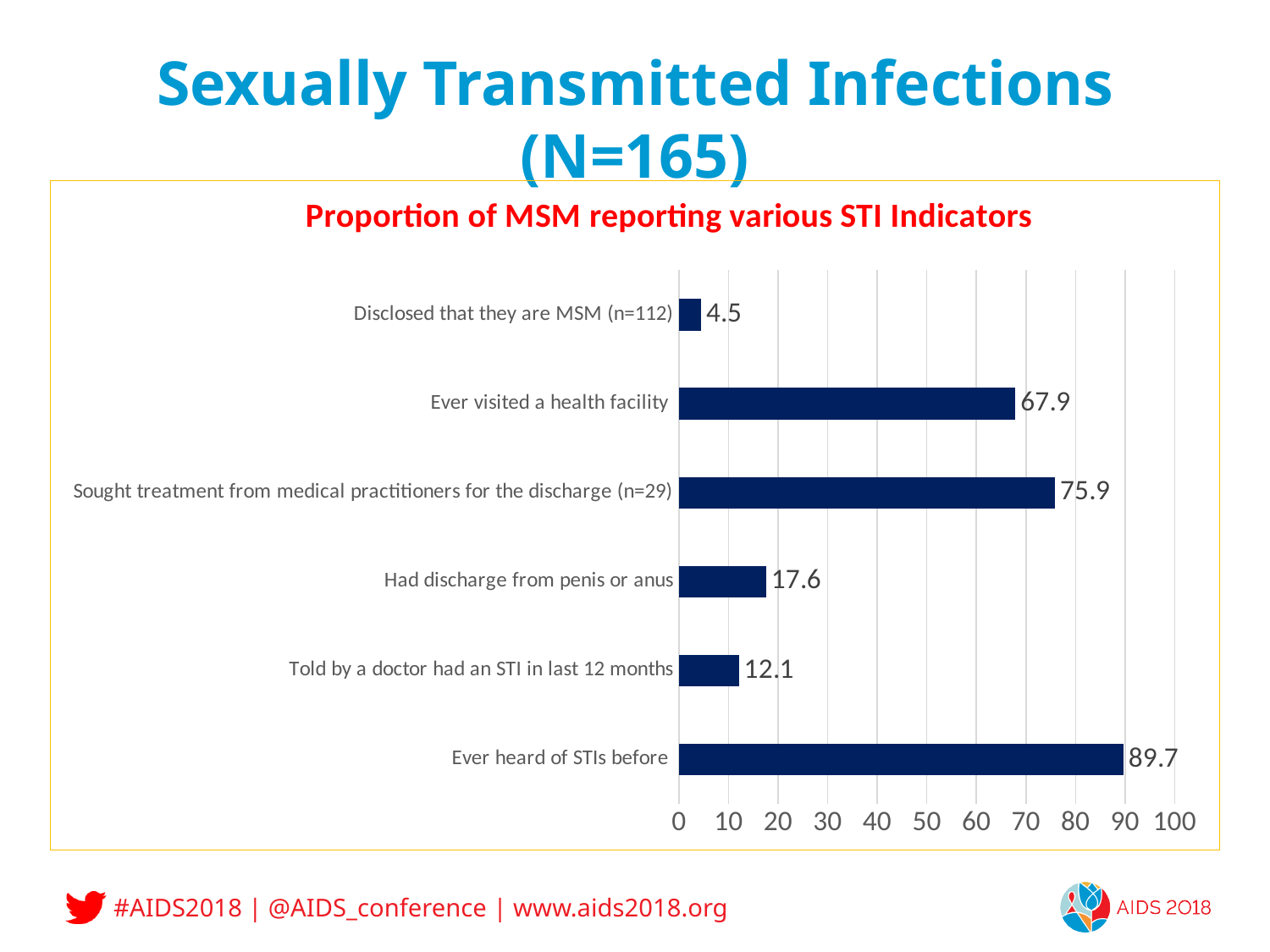
What kind of chart is shown on the slide? Bar chart Which category has the lowest value? Disclosed that they are MSM (n=112) Which is larger: 'Had discharge from penis or anus' or 'Told by a doctor had an STI in last 12 months'? Had discharge from penis or anus What is the value for 'Ever heard of STIs before'? 89.7 Which category has the highest value? Ever heard of STIs before What is the maximum value shown on the x axis? 100 What is the difference between 'Sought treatment from medical practitioners for the discharge (n=29)' and 'Ever visited a health facility'? 8 How many categories are shown in the chart? 6 What is the title of the chart? Proportion of MSM reporting various STI Indicators What is the value for 'Disclosed that they are MSM (n=112)'? 4.5 Is the value for 'Ever visited a health facility' greater or less than 60? greater What is the value for 'Had discharge from penis or anus'? 17.6